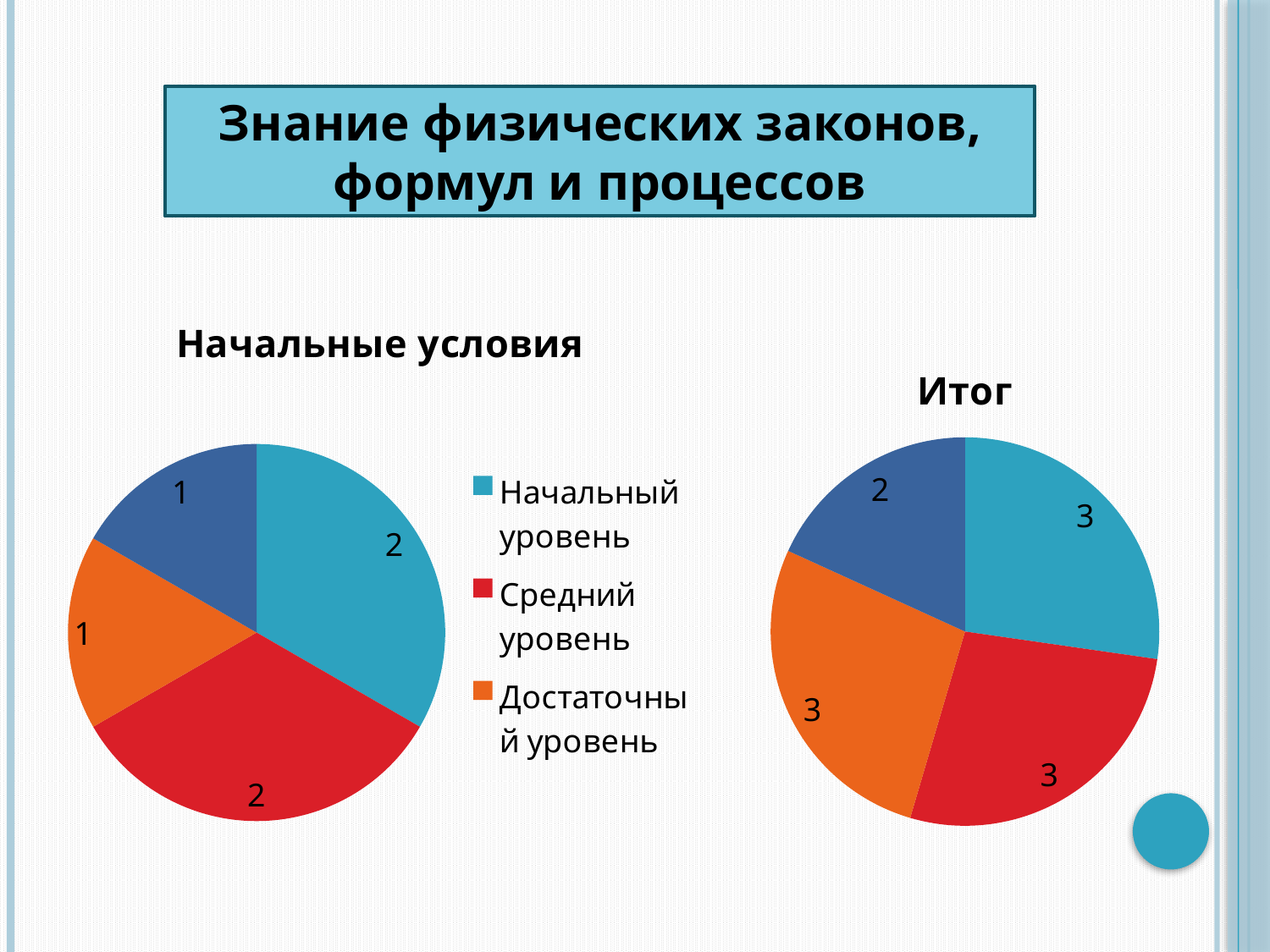
In the 'Начальные условия' pie chart, which is larger: Начальный уровень or Достаточный уровень? Начальный уровень In the 'Начальные условия' pie chart, what is the value for Начальный уровень? 2 How many slices does the 'Начальные условия' pie chart have? 4 How many entries does the legend list? 3 In the 'Начальные условия' pie chart, what is the value for Достаточный уровень? 1 What kind of chart is the 'Итог' chart? Pie chart What colour represents Средний уровень in the legend? Red In the 'Начальные условия' pie chart, what is the value for Средний уровень? 2